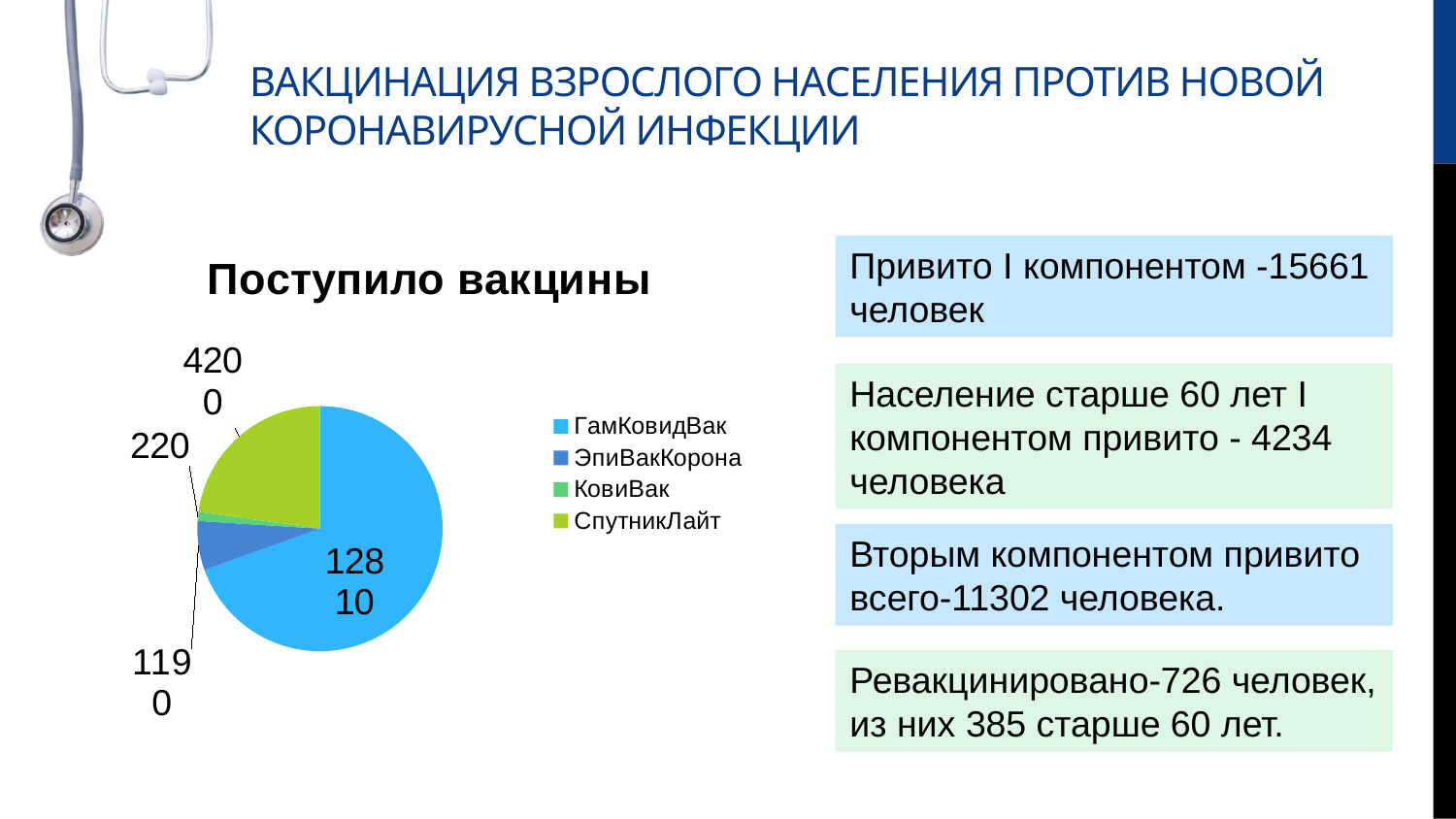
What value is shown for ЭпиВакКорона in the pie chart? 1190 Which vaccine has the smallest slice in the pie chart? КовиВак What value is shown for ГамКовидВак in the pie chart? 12810 Which vaccine has the largest slice in the pie chart? ГамКовидВак What kind of chart is shown under the heading "Поступило вакцины"? pie chart Which slice is larger in the pie chart, СпутникЛайт or ЭпиВакКорона? СпутникЛайт How many vaccine types does the legend of the pie chart list? 4 What is the title of the pie chart? Поступило вакцины How many slices does the pie chart have? 4 What value is shown for СпутникЛайт in the pie chart? 4200 What colour is the ГамКовидВак slice in the pie chart? light blue What value is shown for КовиВак in the pie chart? 220